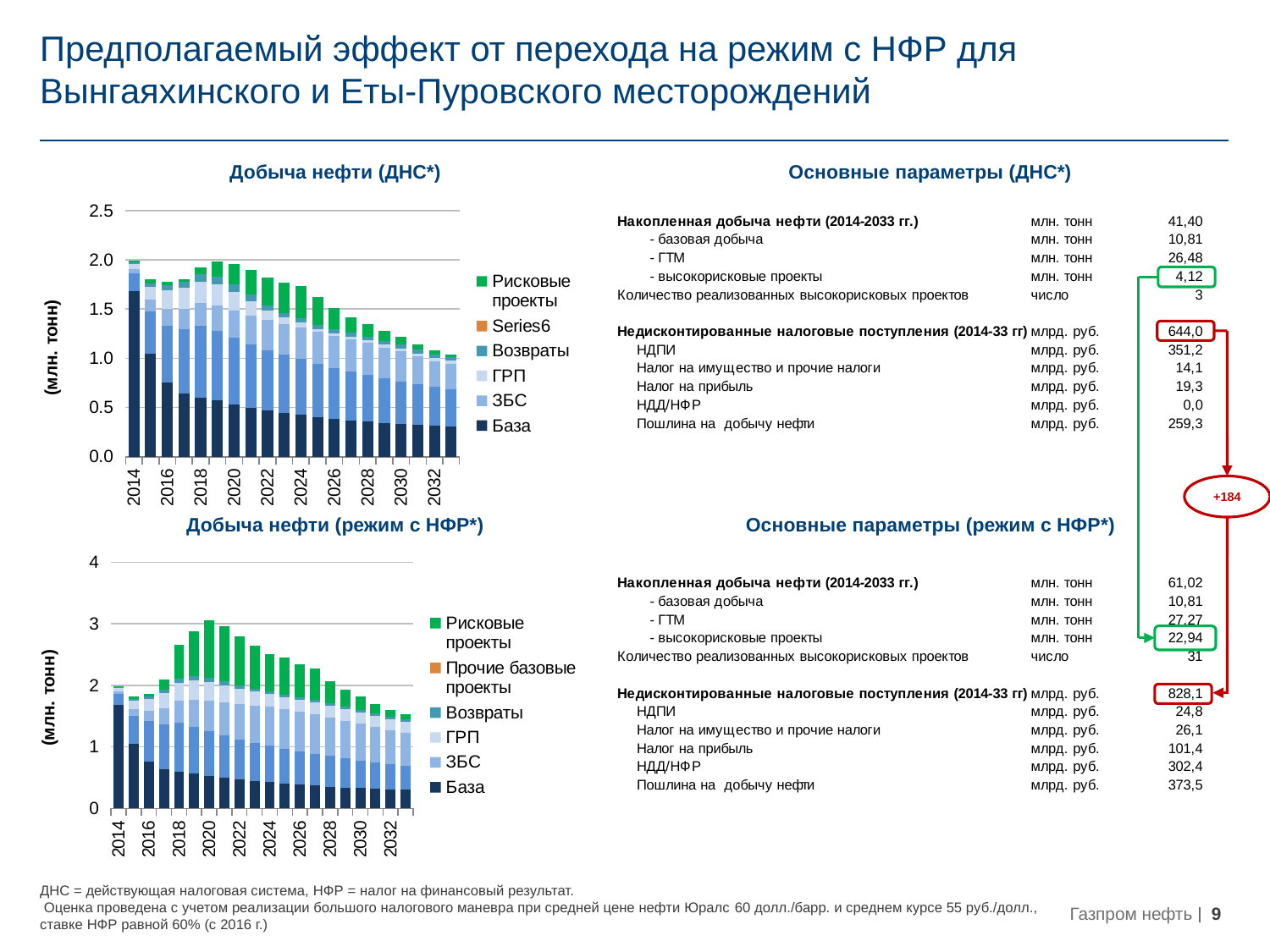
In the "Добыча нефти (ДНС*)" chart, is the total bar height for 2033 greater or less than 1.5? less In the "Добыча нефти (ДНС*)" chart, which total bar is taller, 2014 or 2033? 2014 In the "Добыча нефти (режим с НФР*)" chart, do the total bar heights rise or fall from 2020 to 2033? fall What is the y-axis label of the "Добыча нефти (ДНС*)" chart? (млн. тонн) In the "Добыча нефти (ДНС*)" chart, is the total bar height for 2014 greater or less than 1.5? greater How many series does the legend of the "Добыча нефти (режим с НФР*)" chart list? 6 In the "Добыча нефти (режим с НФР*)" chart, is the total bar height for 2033 greater or less than 2? less How many series does the legend of the "Добыча нефти (ДНС*)" chart list? 6 In the "Добыча нефти (ДНС*)" chart, which year has the shortest total bar? 2033 What kind of chart is "Добыча нефти (ДНС*)"? stacked bar chart In the "Добыча нефти (режим с НФР*)" chart, which year has the tallest total bar? 2020